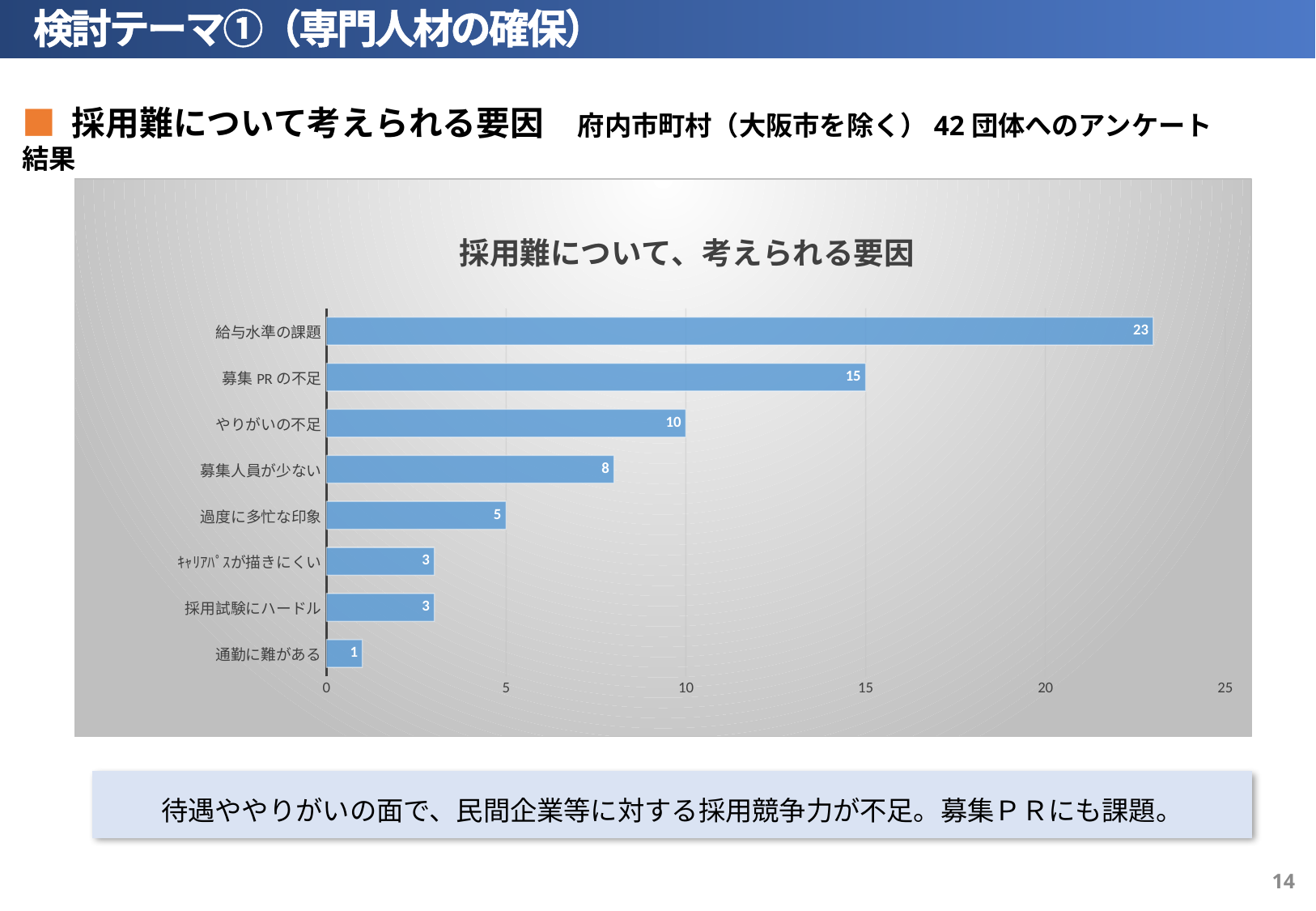
What is the value for やりがいの不足? 10 Which is larger, the value for 募集人員が少ない or the value for 過度に多忙な印象? 募集人員が少ない Which category has the highest value? 給与水準の課題 What is the title of the chart? 採用難について、考えられる要因 What is the value for 募集PRの不足? 15 Is the value for やりがいの不足 greater or less than 5? greater Which category has the lowest value? 通勤に難がある What kind of chart is shown on the slide? bar chart What is the difference between the values for 給与水準の課題 and 募集PRの不足? 8 What is the value for 給与水準の課題? 23 What is the value for 通勤に難がある? 1 How many categories are shown in the chart? 8